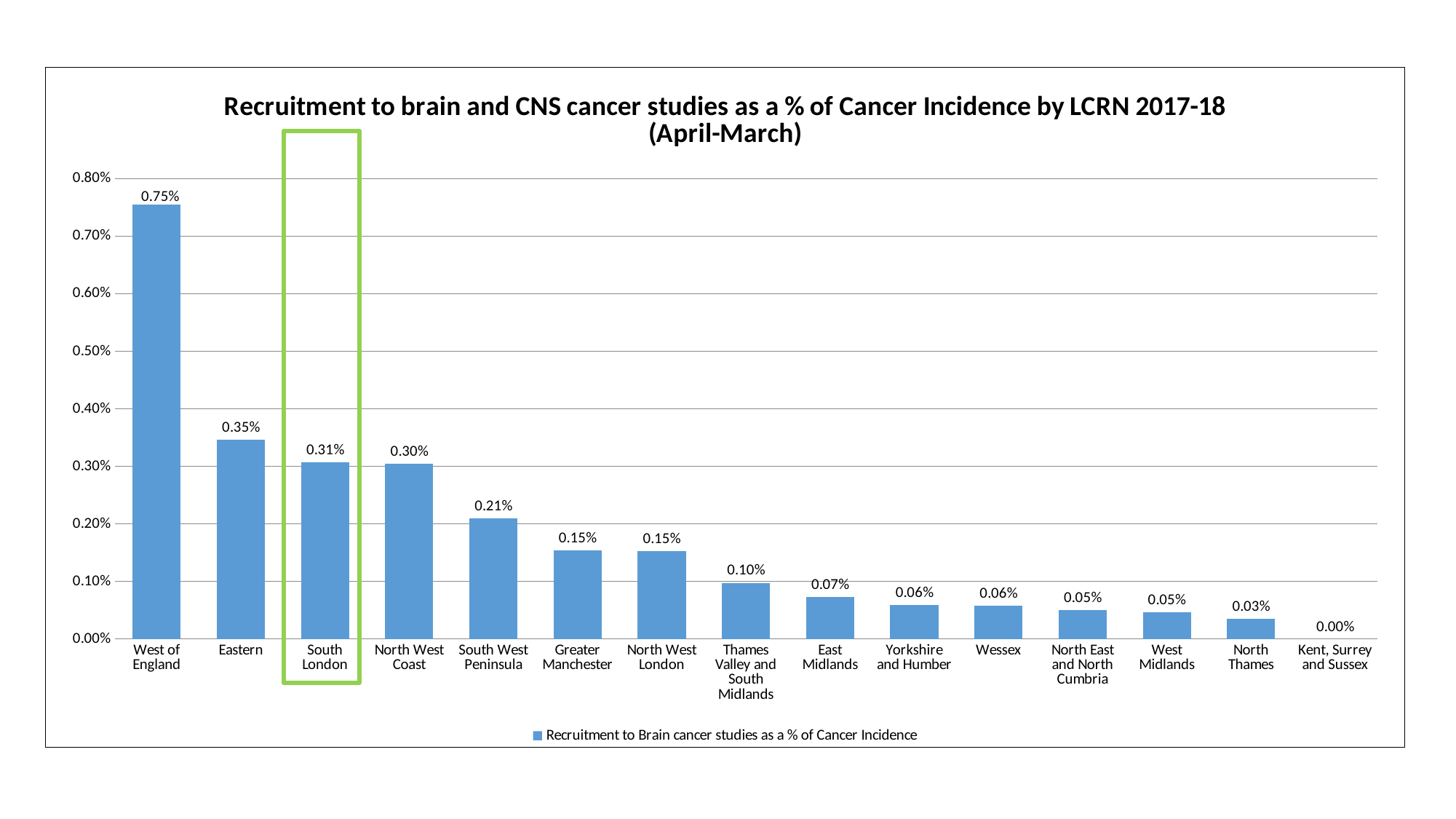
What kind of chart is this? bar chart What is the value for South London? 0.31% Which LCRN has the highest recruitment percentage? West of England Is the value for West of England greater or less than 0.70%? greater What is the value for North Thames? 0.03% What is the difference between the values for West of England and Eastern? 0.40% What is the value for Thames Valley and South Midlands? 0.10% What is the difference between the values for South West Peninsula and Greater Manchester? 0.06% Which category is highlighted with a green box? South London Which LCRN has the lowest recruitment percentage? Kent, Surrey and Sussex How many LCRNs are shown on the x axis? 15 Which is larger, the value for Eastern or the value for South London? Eastern